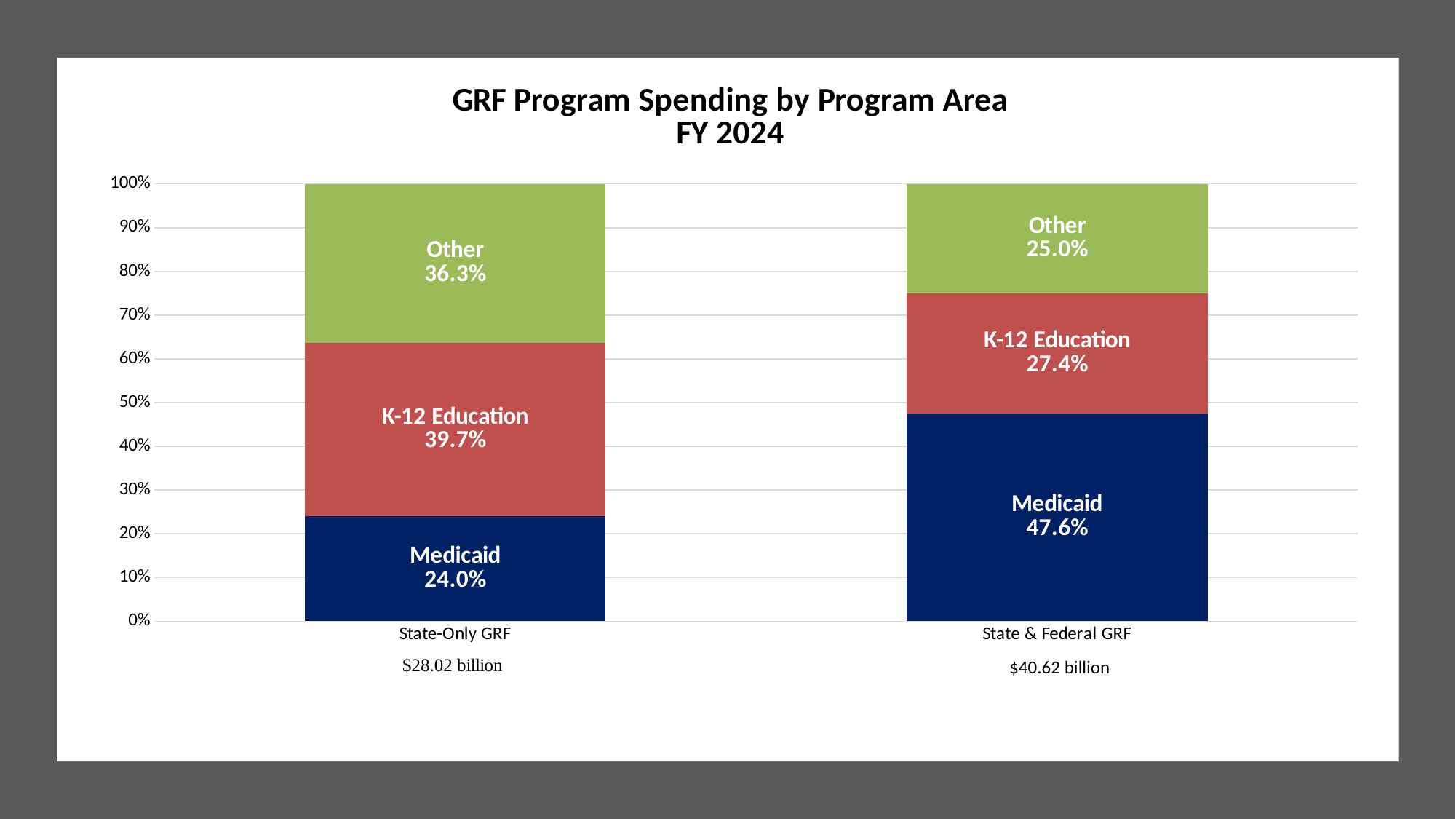
What is the K-12 Education share of State & Federal GRF spending? 27.4% What is the difference between the Medicaid share in State & Federal GRF and the Medicaid share in State-Only GRF? 23.6% What is the Other share of State-Only GRF spending? 36.3% What is the Medicaid share of State-Only GRF spending? 24.0% How many program areas are shown in each stacked bar? 3 Which program area has the largest share of State-Only GRF spending? K-12 Education What is the Medicaid share of State & Federal GRF spending? 47.6% What total dollar amount is shown beneath the State & Federal GRF bar? $40.62 billion What type of chart is shown on the slide? Stacked bar chart Which is larger: the K-12 Education share in State-Only GRF or in State & Federal GRF? State-Only GRF Which program area has the smallest share of State & Federal GRF spending? Other How many stacked bars are shown in the chart? 2